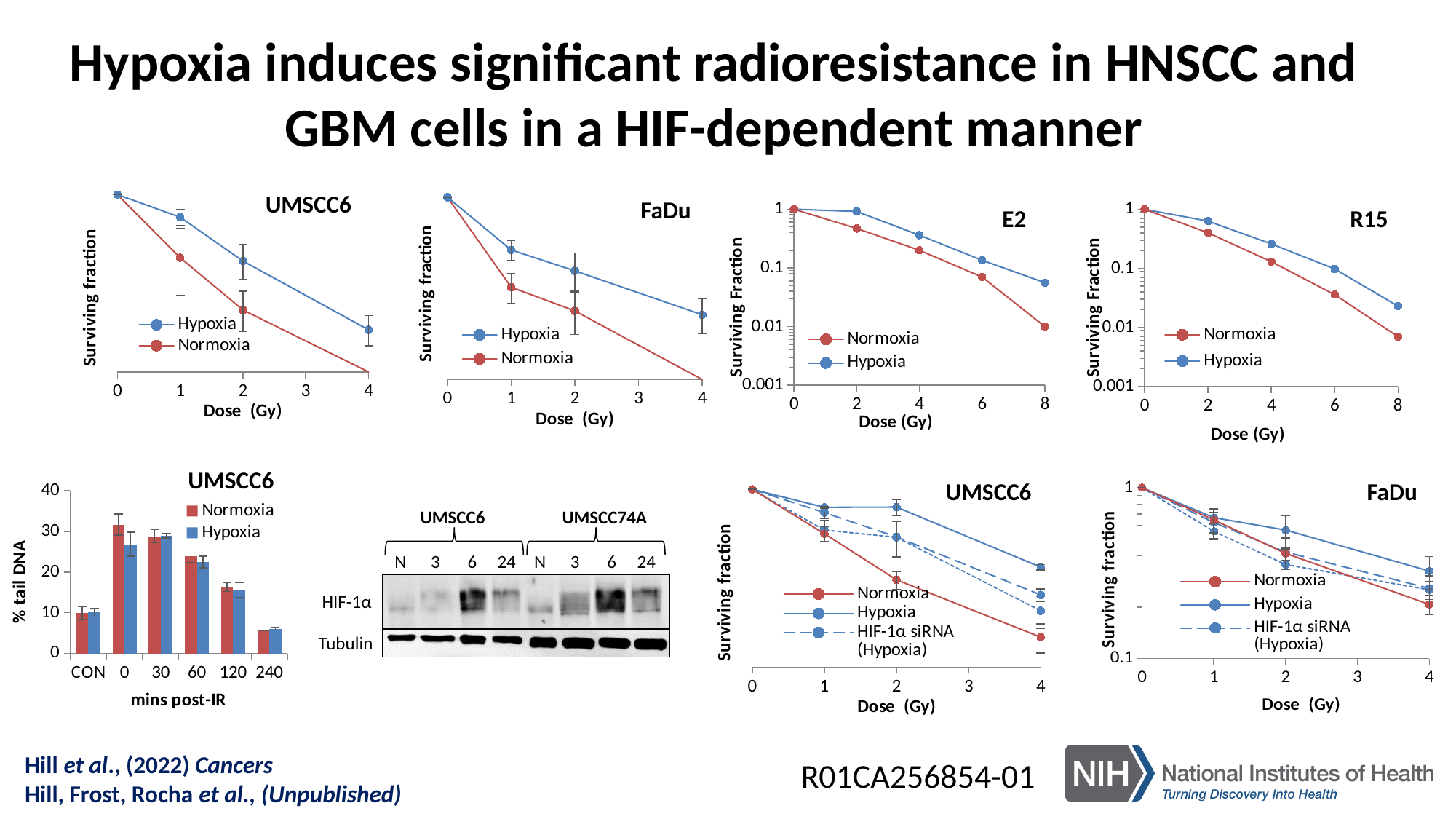
How many series does the legend of the E2 chart list? 2 In the bottom-left UMSCC6 bar chart, how many categories are shown on the x axis? 6 In the E2 chart, at 8 Gy, which series has the larger surviving fraction: Hypoxia or Normoxia? Hypoxia In the bottom-left UMSCC6 bar chart, at which time point is the Normoxia value highest? 0 How many series does the legend of the bottom-right FaDu chart list? 3 In the bottom-left UMSCC6 bar chart, is the Normoxia value at 0 mins post-IR greater or less than 30? greater In the R15 chart, does the surviving fraction rise or fall as dose increases? fall In the top-left UMSCC6 chart, what colour is the Hypoxia series? blue In the bottom-left UMSCC6 bar chart, at 0 mins post-IR, which is larger: Normoxia or Hypoxia? Normoxia What kind of chart is the bottom-left UMSCC6 chart showing % tail DNA? bar chart In the bottom-left UMSCC6 bar chart, at which time point is the Normoxia value lowest? 240 In the R15 chart, is the Normoxia surviving fraction at 8 Gy greater or less than 0.01? less